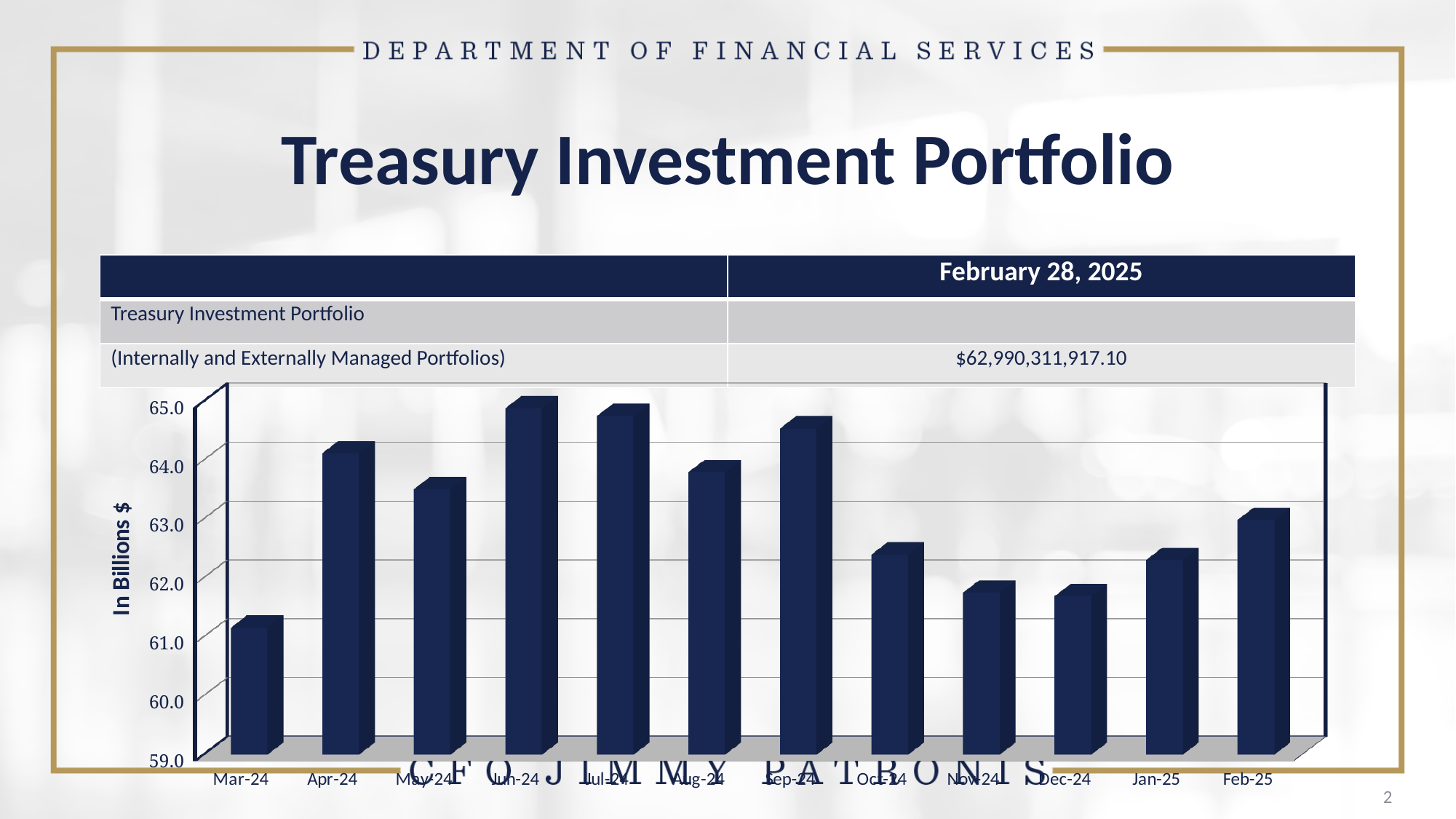
Is the value for Feb-25 greater or less than 62.0? greater What kind of chart is shown on the slide? bar chart What is the label on the vertical axis of the chart? In Billions $ Which is larger, the value for Sep-24 or the value for Oct-24? Sep-24 Is the value for Nov-24 greater or less than 62.0? less Which is larger, the value for Apr-24 or the value for May-24? Apr-24 Which month has the highest bar in the chart? Jun-24 How many months are plotted on the x axis of the chart? 12 Is the value for Oct-24 greater or less than 63.0? less Which month has the lowest bar in the chart? Mar-24 Do the values rise or fall from Sep-24 to Dec-24? fall